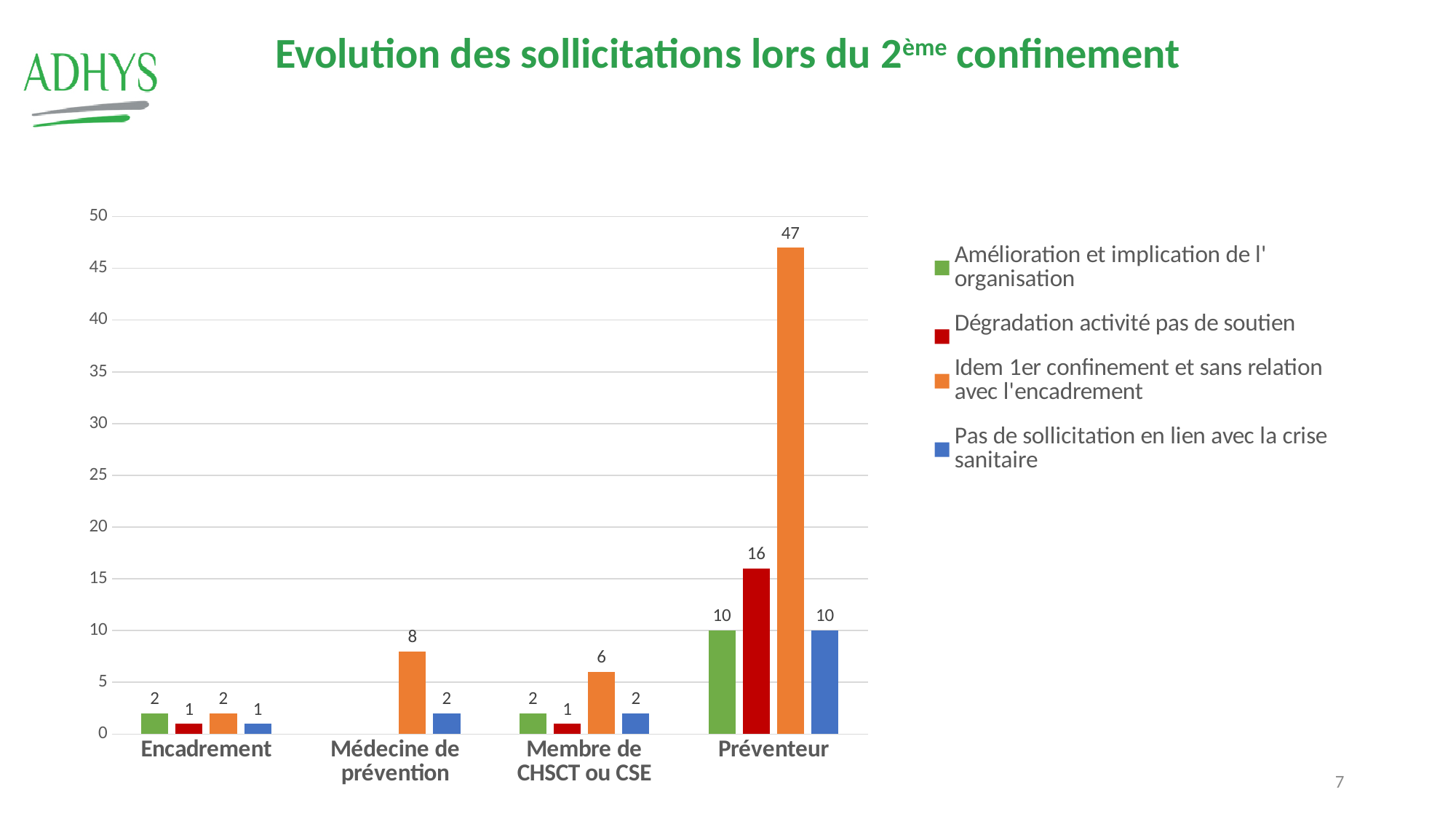
Is the value for 'Idem 1er confinement et sans relation avec l'encadrement' in the Préventeur category greater or less than 45? greater What kind of chart is shown on the slide? bar chart Which category has the lowest value for 'Idem 1er confinement et sans relation avec l'encadrement'? Encadrement In the Membre de CHSCT ou CSE category, which is larger: 'Idem 1er confinement et sans relation avec l'encadrement' or 'Amélioration et implication de l'organisation'? Idem 1er confinement et sans relation avec l'encadrement What is the value for 'Dégradation activité pas de soutien' in the Préventeur category? 16 What is the value for 'Idem 1er confinement et sans relation avec l'encadrement' in the Médecine de prévention category? 8 What is the difference between the 'Idem 1er confinement et sans relation avec l'encadrement' value and the 'Dégradation activité pas de soutien' value in the Préventeur category? 31 What is the value for 'Pas de sollicitation en lien avec la crise sanitaire' in the Membre de CHSCT ou CSE category? 2 How many series does the legend list? 4 How many categories are shown on the x axis? 4 What is the value for 'Idem 1er confinement et sans relation avec l'encadrement' in the Préventeur category? 47 Which category has the highest value for 'Idem 1er confinement et sans relation avec l'encadrement'? Préventeur